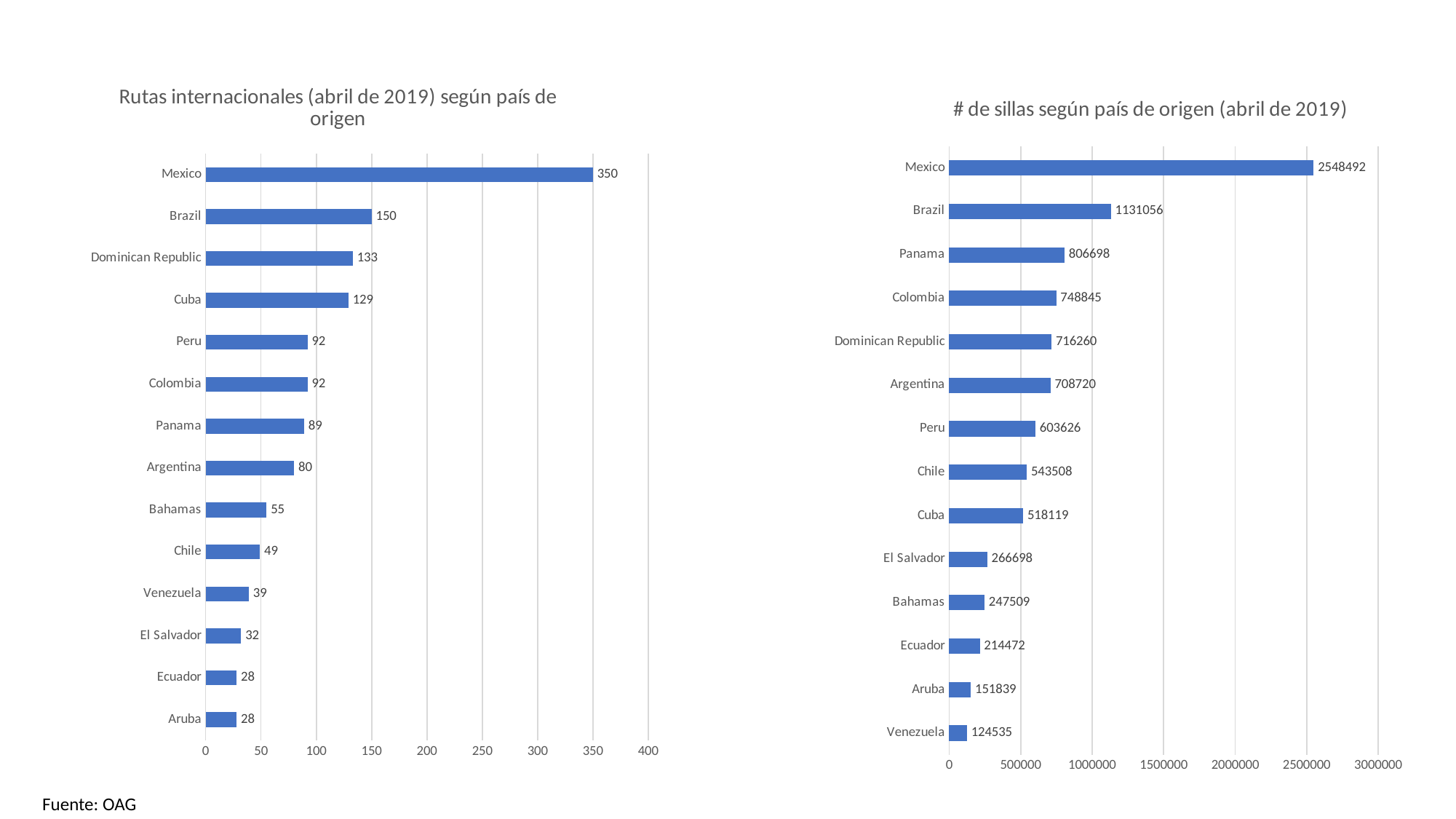
In the chart '# de sillas según país de origen (abril de 2019)', what is the difference between the values for Mexico and Brazil? 1417436 In the chart 'Rutas internacionales (abril de 2019) según país de origen', what is the difference between the values for Mexico and Brazil? 200 In the chart '# de sillas según país de origen (abril de 2019)', what is the value for Panama? 806698 In the chart 'Rutas internacionales (abril de 2019) según país de origen', which country has the highest value? Mexico In the chart 'Rutas internacionales (abril de 2019) según país de origen', what is the value for Brazil? 150 In the chart 'Rutas internacionales (abril de 2019) según país de origen', how many countries are shown? 14 In the chart '# de sillas según país de origen (abril de 2019)', is the value for Peru greater or less than 500000? greater What kind of chart is the chart on the right of the slide? Bar chart In the chart '# de sillas según país de origen (abril de 2019)', which country has the lowest value? Venezuela In the chart 'Rutas internacionales (abril de 2019) según país de origen', is the value for Cuba greater or less than 100? greater What source is cited at the bottom of the slide? OAG In the chart '# de sillas según país de origen (abril de 2019)', which is larger, the value for Chile or the value for Cuba? Chile